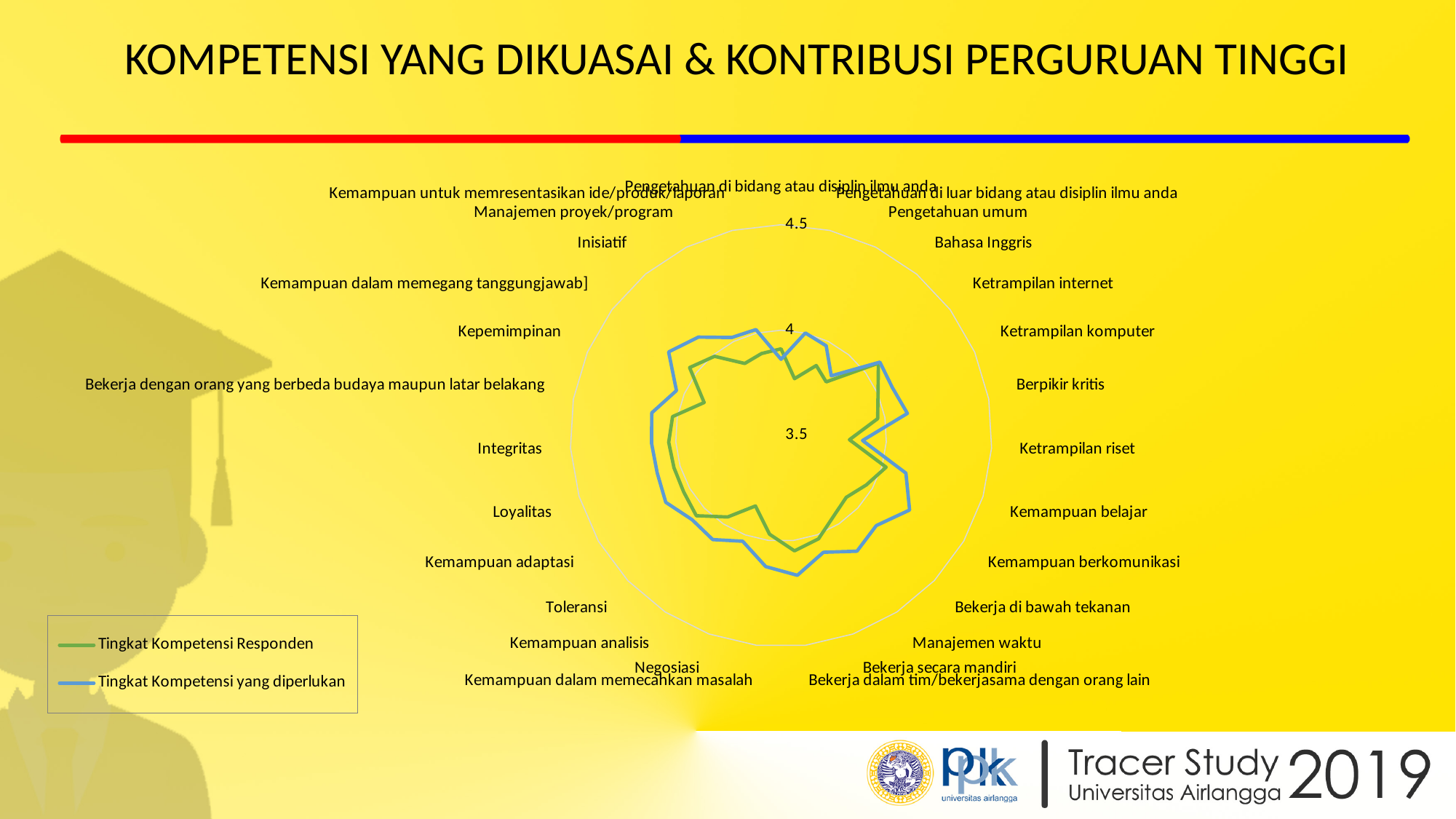
For Kemampuan belajar, which series has the larger value: Tingkat Kompetensi Responden or Tingkat Kompetensi yang diperlukan? Tingkat Kompetensi yang diperlukan Which colour represents the series 'Tingkat Kompetensi yang diperlukan'? Blue What are the two series named in the legend? Tingkat Kompetensi Responden; Tingkat Kompetensi yang diperlukan How many series does the legend list? 2 Is the value of 'Tingkat Kompetensi yang diperlukan' for Kemampuan belajar greater or less than 4? greater Is the value of 'Tingkat Kompetensi yang diperlukan' for Berpikir kritis greater or less than 4? greater Is the value of 'Tingkat Kompetensi Responden' for Ketrampilan riset greater or less than 4? less How many competency categories are plotted around the radar chart? 27 For Berpikir kritis, which series has the larger value: Tingkat Kompetensi Responden or Tingkat Kompetensi yang diperlukan? Tingkat Kompetensi yang diperlukan What kind of chart is shown on the slide? Radar chart